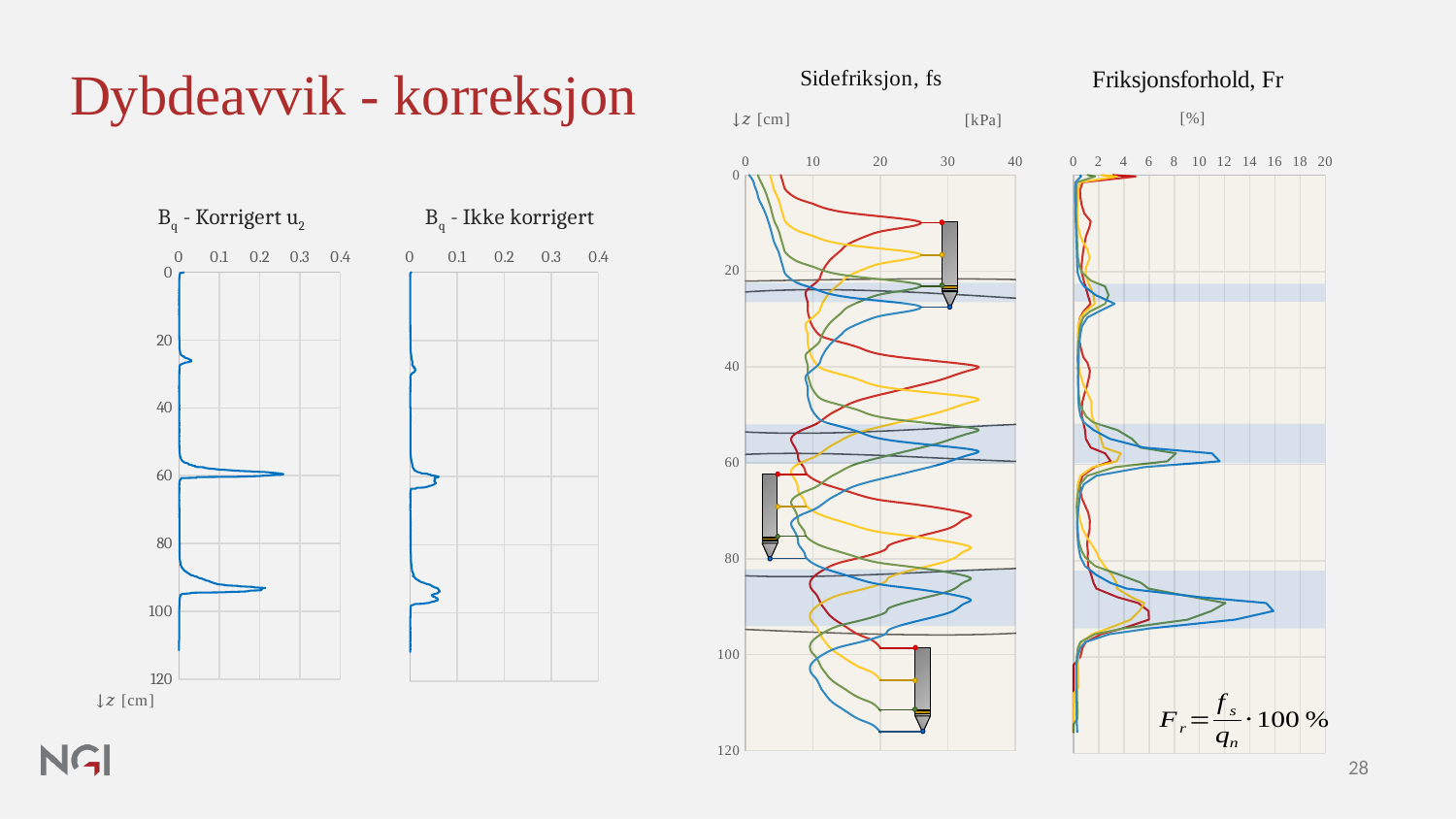
In the 'Sidefriksjon, fs' chart, is the blue line's value at a depth of 0 cm greater or less than 10 kPa? less What kind of chart is the 'Bq - Korrigert u2' chart? line chart In the 'Friksjonsforhold, Fr' chart, is the blue line's peak near a depth of 90 cm greater or less than 10%? greater In the 'Bq - Korrigert u2' chart, is the peak value near a depth of 60 cm greater or less than 0.2? greater What is the maximum value on the horizontal axis of the 'Friksjonsforhold, Fr' chart? 20 What is the unit shown on the horizontal axis of the 'Sidefriksjon, fs' chart? kPa What kind of chart is the 'Sidefriksjon, fs' chart? line chart How many charts are shown on the slide? 4 In the 'Bq - Korrigert u2' chart, which peak is larger: the one near 60 cm depth or the one near 95 cm depth? the one near 60 cm